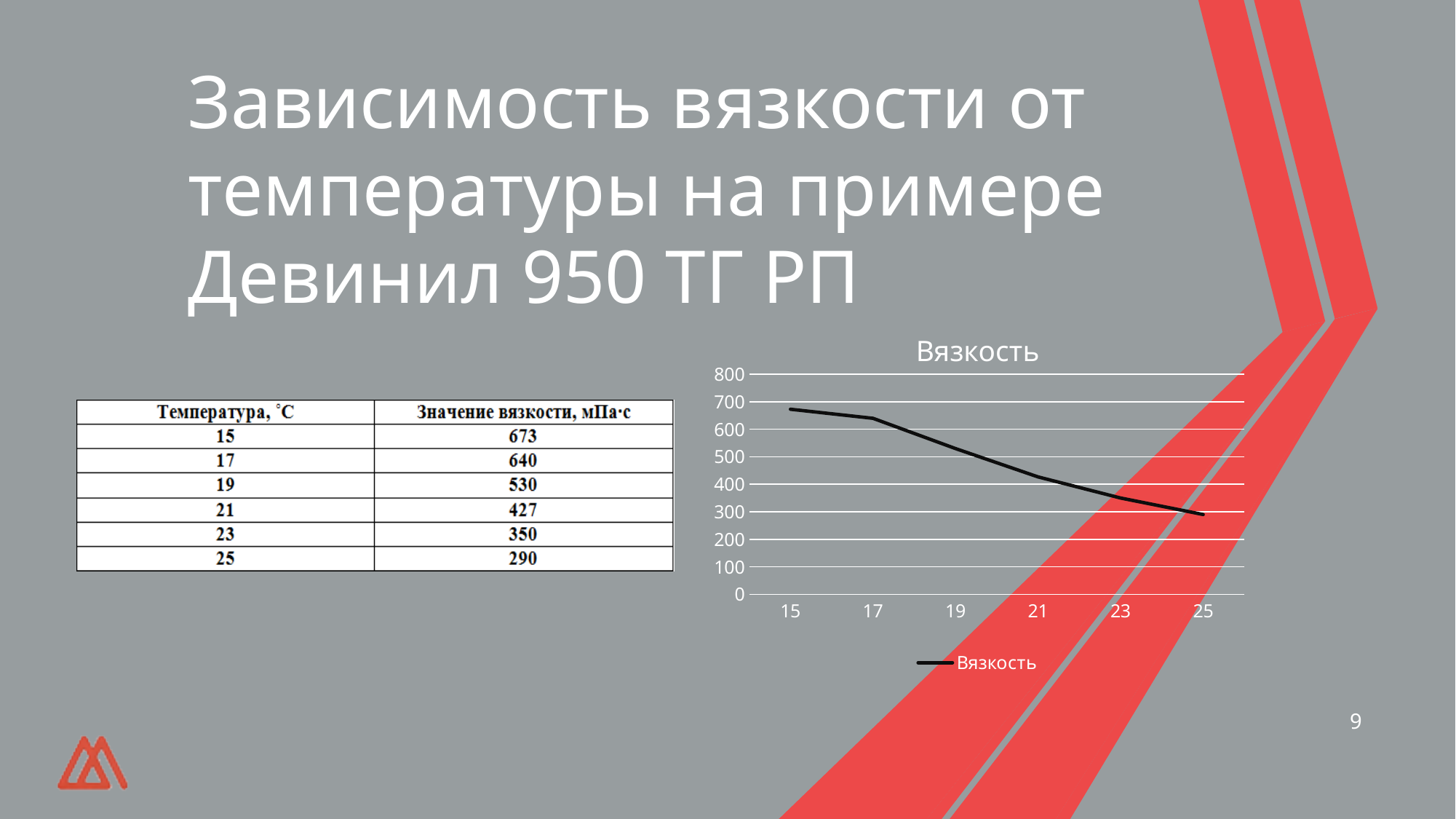
Is the viscosity value at 25 °C greater or less than 300? less Is the viscosity value at 21 °C greater or less than 500? less Which has the larger viscosity value, 17 °C or 23 °C? 17 °C What kind of chart is shown on the slide? line chart Is the viscosity value at 15 °C greater or less than 600? greater What is the title of the chart? Вязкость At which temperature is the viscosity highest? 15 According to the table on the slide, what is the viscosity value at 19 °C? 530 At which temperature is the viscosity lowest? 25 How many temperature points are plotted on the chart? 6 Does the viscosity rise or fall as temperature increases along the x axis? falls How many series does the chart legend list? 1